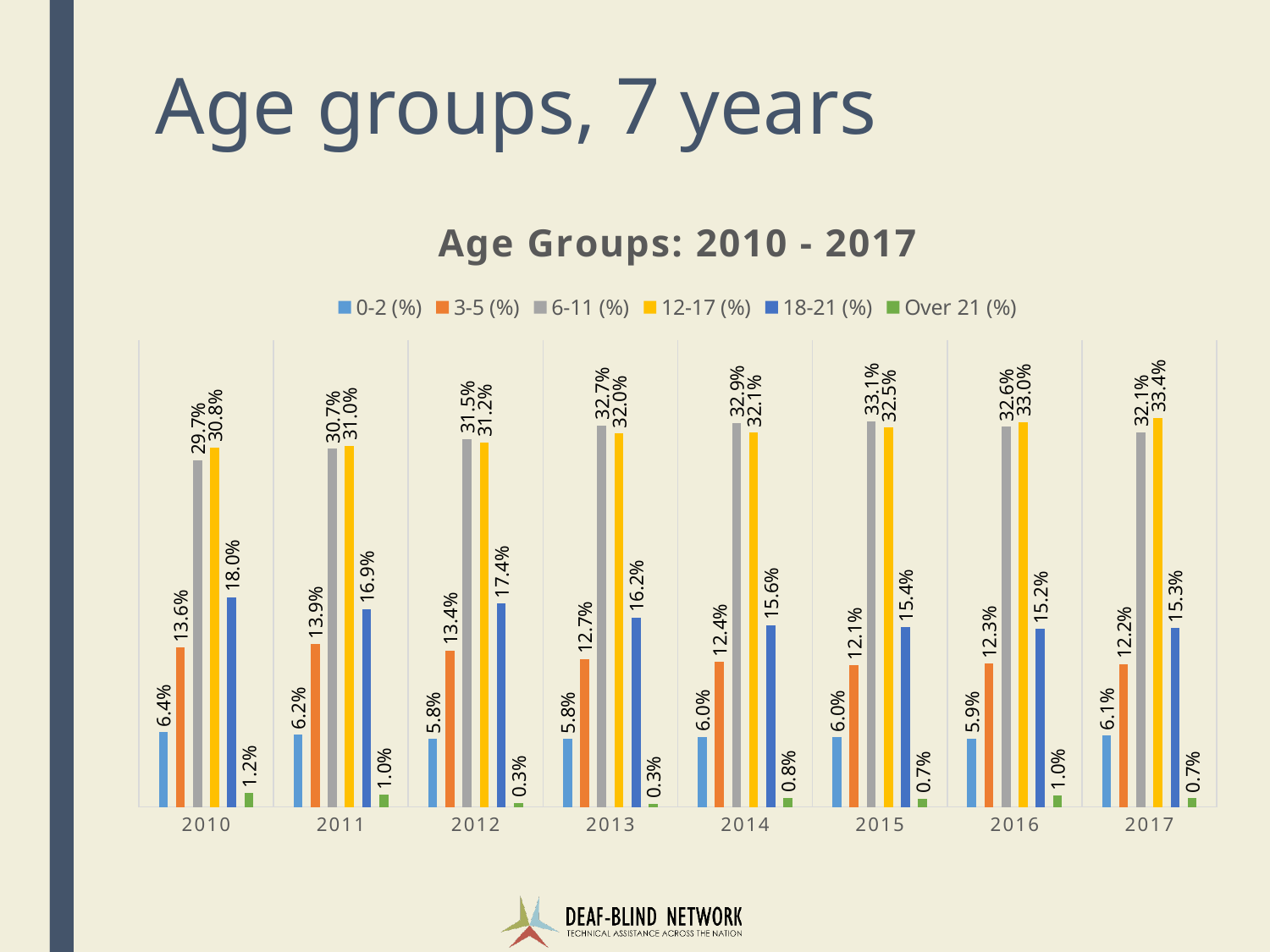
Does the 3-5 (%) series generally rise or fall from 2011 to 2015? Fall How many years are shown on the x axis? 8 What kind of chart is shown on the slide? Bar chart What is the value for the 3-5 (%) series in 2015? 12.1% How many series does the legend list? 6 In which year is the 18-21 (%) series lowest? 2016 Which is larger in 2012, the 6-11 (%) value or the 12-17 (%) value? 6-11 (%) What is the value for the 12-17 (%) series in 2017? 33.4% What is the value for the 18-21 (%) series in 2010? 18.0% What is the difference between the 18-21 (%) values for 2010 and 2017? 2.7% What is the value for the Over 21 (%) series in 2013? 0.3% In which year is the 6-11 (%) series highest? 2015